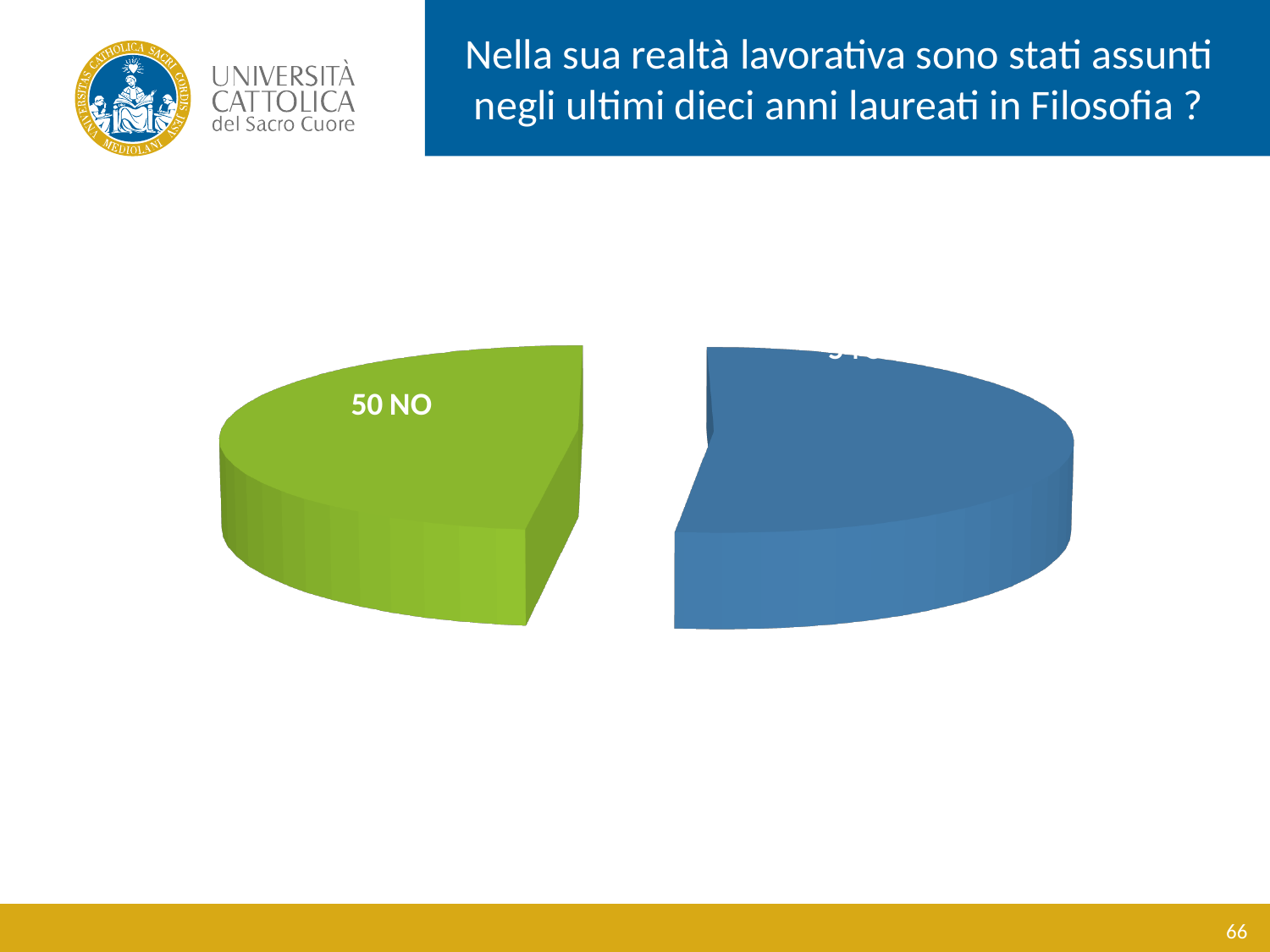
What colour is the NO slice of the pie chart? green How many slices does the pie chart have? 2 What kind of chart is shown on the slide? pie chart What question does the slide title pose above the pie chart? Nella sua realtà lavorativa sono stati assunti negli ultimi dieci anni laureati in Filosofia ? What value is printed on the NO slice of the pie chart? 50